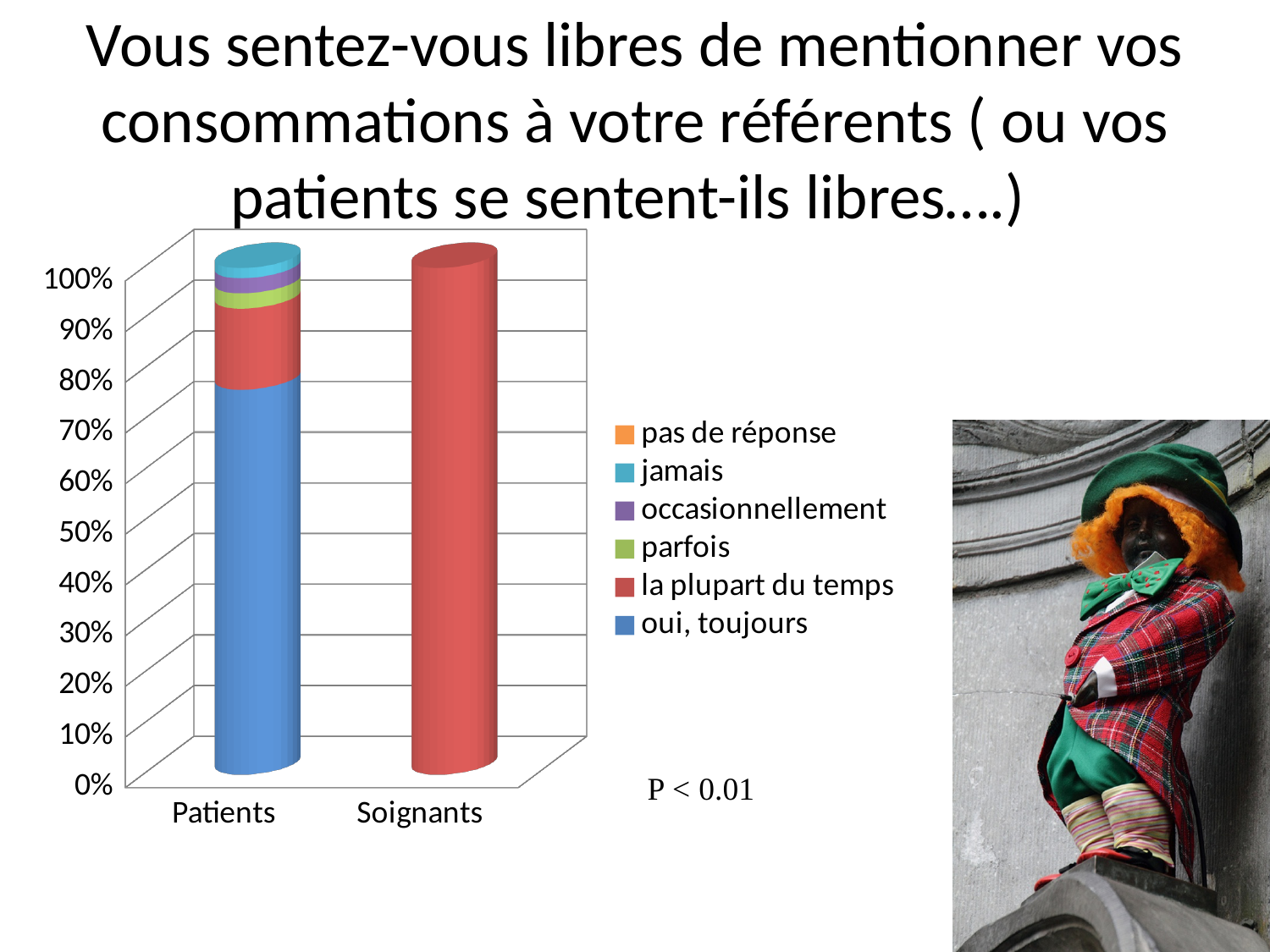
Is the 'oui, toujours' value for Patients greater or less than 70%? greater How many categories are shown on the x axis of the chart? 2 Is the 'oui, toujours' value for Patients greater or less than 90%? less How many series does the chart legend list? 6 Which category has the larger 'la plupart du temps' value, Patients or Soignants? Soignants Is the 'la plupart du temps' value for Patients greater or less than 30%? less What kind of chart is shown on the slide? stacked bar chart Which category has the larger 'oui, toujours' value, Patients or Soignants? Patients Which single series makes up the entire bar for Soignants? la plupart du temps Which category shows a visible 'jamais' segment? Patients Which two categories are shown on the x axis? Patients and Soignants